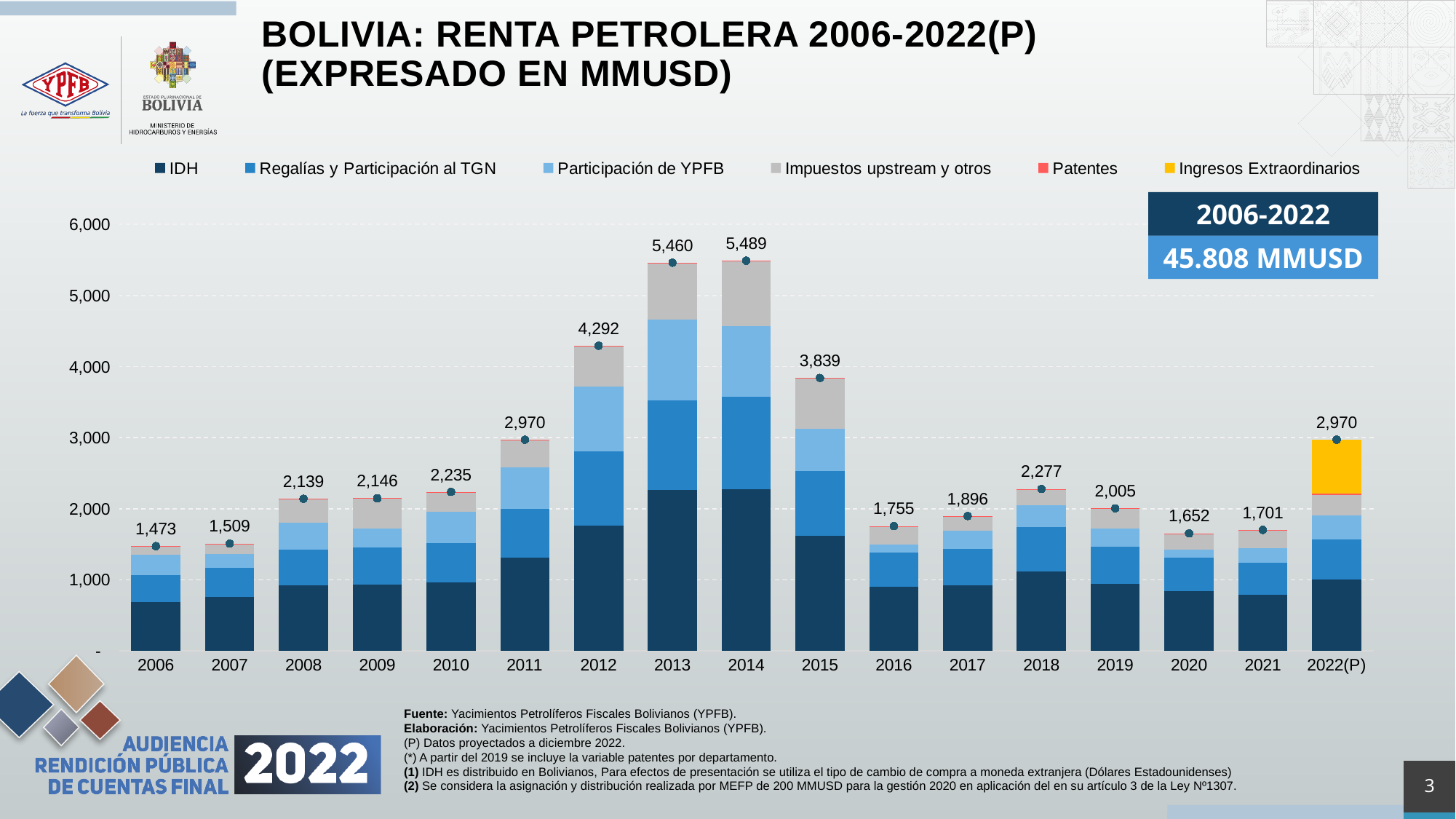
How many years are shown on the x axis? 17 Is the IDH value for 2013 greater or less than 2,000? greater What kind of chart is shown on the slide? Stacked bar chart Which total is larger, 2018 or 2019? 2018 How many series does the legend list? 6 What is the total renta petrolera shown for 2013? 5,460 What is the difference between the totals for 2014 and 2013? 29 What is the difference between the totals for 2022(P) and 2021? 1,269 Which series is shown in yellow in the legend? Ingresos Extraordinarios Which year has the highest total renta petrolera? 2014 Which year has the lowest total renta petrolera? 2006 What is the total value labeled for 2022(P)? 2,970